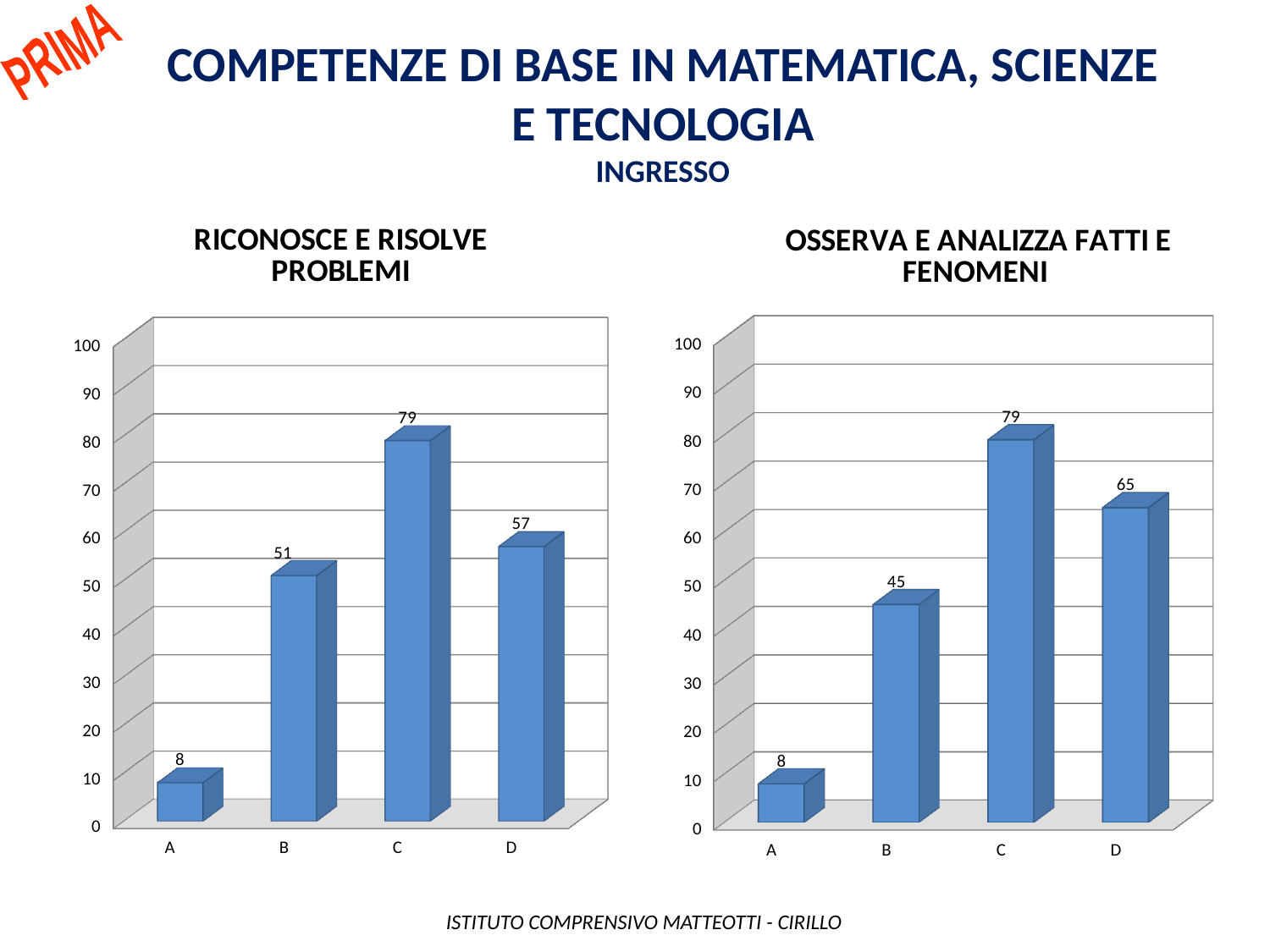
How many categories are shown in the 'RICONOSCE E RISOLVE PROBLEMI' chart? 4 In the 'OSSERVA E ANALIZZA FATTI E FENOMENI' chart, what is the value for category B? 45 What kind of chart is the 'OSSERVA E ANALIZZA FATTI E FENOMENI' chart? Bar chart In the 'OSSERVA E ANALIZZA FATTI E FENOMENI' chart, what is the difference between the values for D and B? 20 In the 'RICONOSCE E RISOLVE PROBLEMI' chart, what is the value for category B? 51 In the 'RICONOSCE E RISOLVE PROBLEMI' chart, which category has the highest value? C In the 'OSSERVA E ANALIZZA FATTI E FENOMENI' chart, which category has the lowest value? A In the 'RICONOSCE E RISOLVE PROBLEMI' chart, which is larger, the value for B or the value for D? D In the 'RICONOSCE E RISOLVE PROBLEMI' chart, what is the value for category C? 79 In the 'RICONOSCE E RISOLVE PROBLEMI' chart, what is the difference between the values for C and D? 22 In the 'OSSERVA E ANALIZZA FATTI E FENOMENI' chart, what is the value for category D? 65 In the 'OSSERVA E ANALIZZA FATTI E FENOMENI' chart, is the value for C greater or less than 70? greater